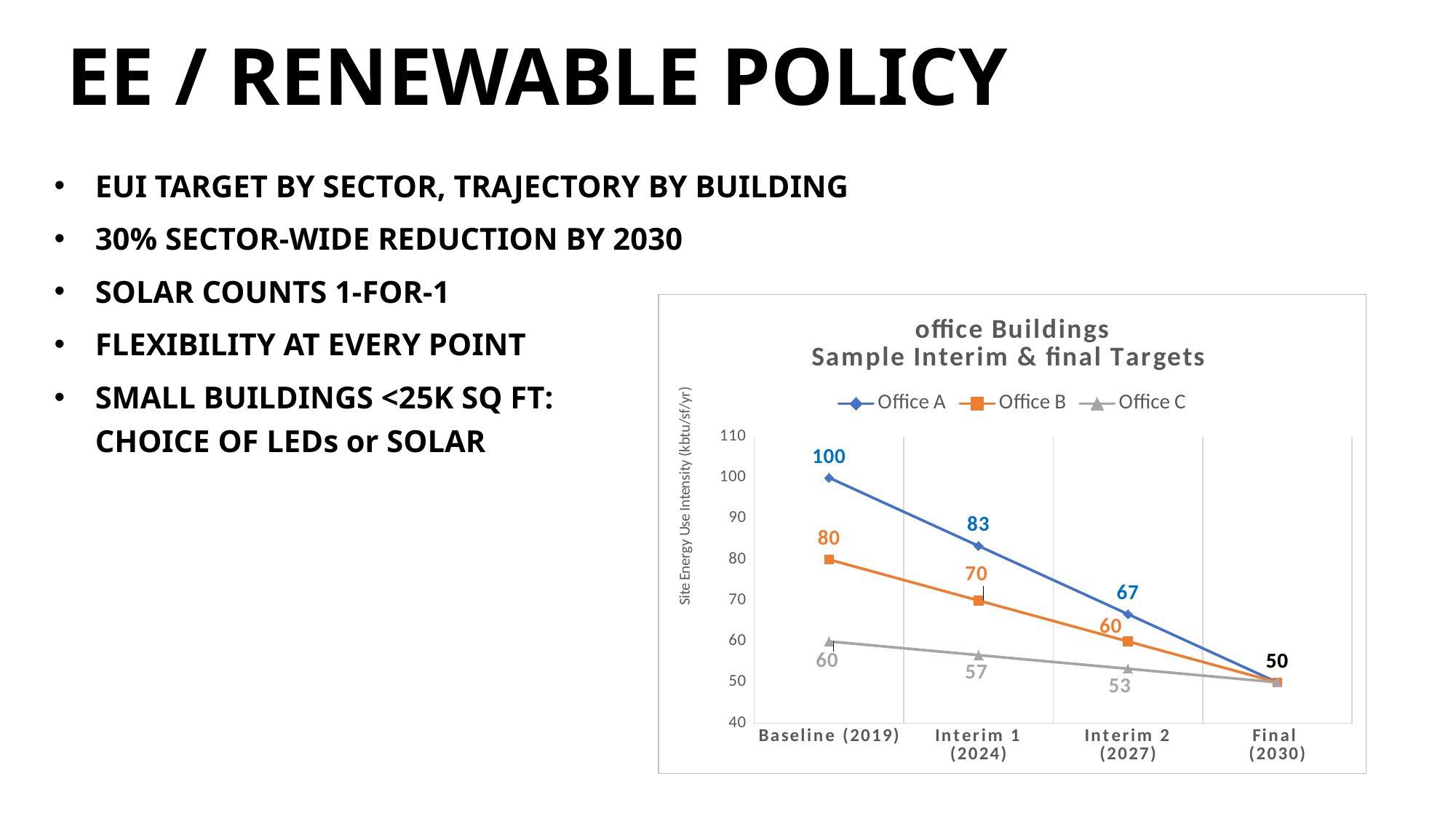
Which office has the lowest value at Interim 1 (2024)? Office C How many series does the legend list? 3 What is the value for Office C at Interim 2 (2027)? 53 Which office has the highest value at Baseline (2019)? Office A What kind of chart is shown? Line chart What is the value for Office A at Baseline (2019)? 100 What is the difference between Office A and Office B at Interim 2 (2027)? 7 What is the value for Office B at Interim 1 (2024)? 70 What is the value at Final (2030) for all three offices? 50 Do the values for Office A rise or fall from Baseline (2019) to Final (2030)? Fall Which is larger at Baseline (2019): Office B or Office C? Office B How many points are on the x axis? 4